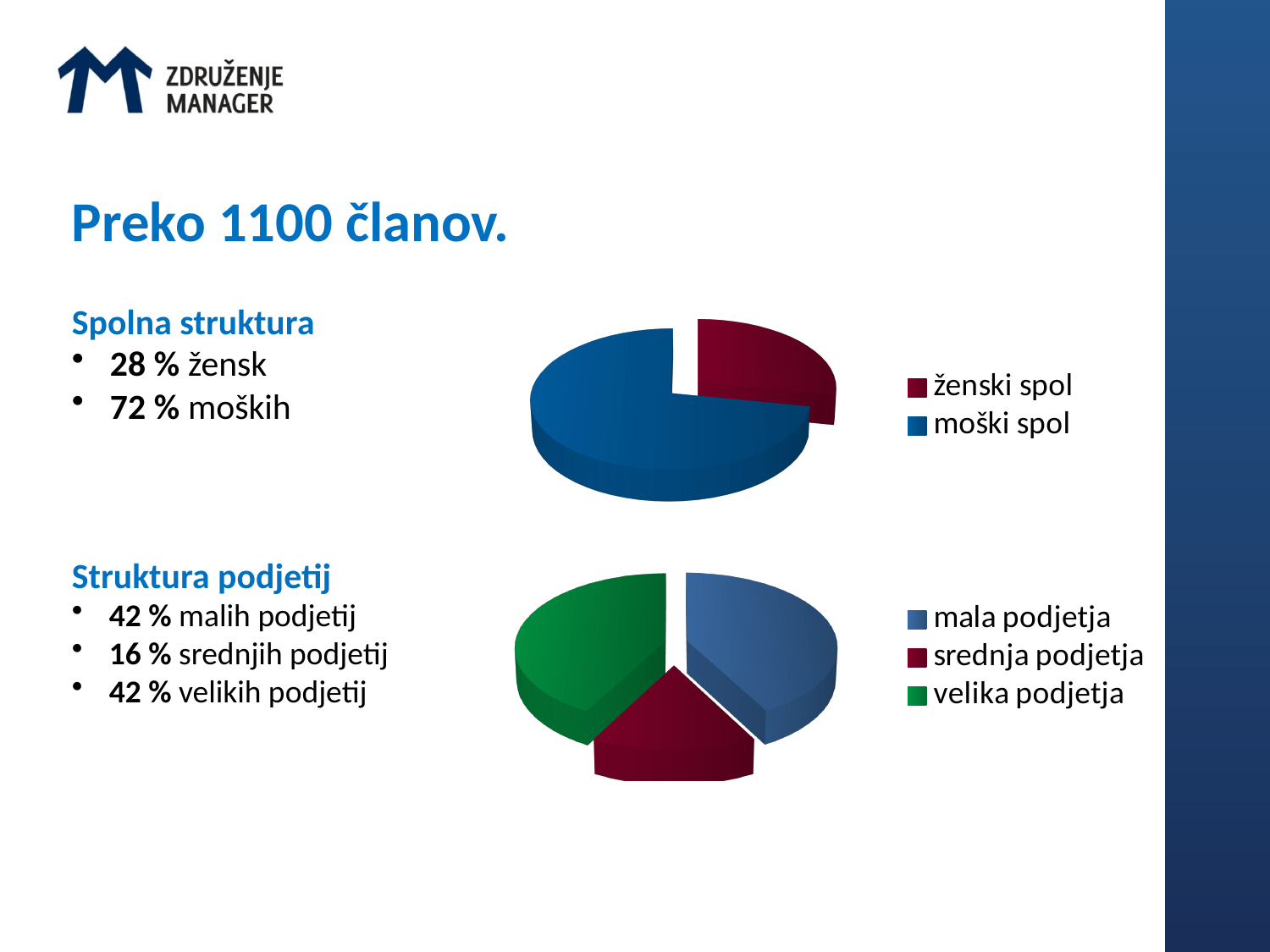
In the top pie chart (Spolna struktura), what is the difference in percentage points between moški spol and ženski spol? 44 In the bottom pie chart (Struktura podjetij), what share do mala podjetja make up? 42 % In the top pie chart (Spolna struktura), what share do ženski spol members make up? 28 % In the top pie chart (Spolna struktura), what share do moški spol members make up? 72 % In the bottom pie chart (Struktura podjetij), what colour is the velika podjetja slice? green In the top pie chart (Spolna struktura), which slice is the largest? moški spol In the bottom pie chart (Struktura podjetij), which is larger: velika podjetja or srednja podjetja? velika podjetja In the top pie chart (Spolna struktura), how many slices are there? 2 In the bottom pie chart (Struktura podjetij), which slice is the smallest? srednja podjetja What kind of chart is the top chart on the slide (Spolna struktura)? pie chart In the bottom pie chart (Struktura podjetij), how many categories does the legend list? 3